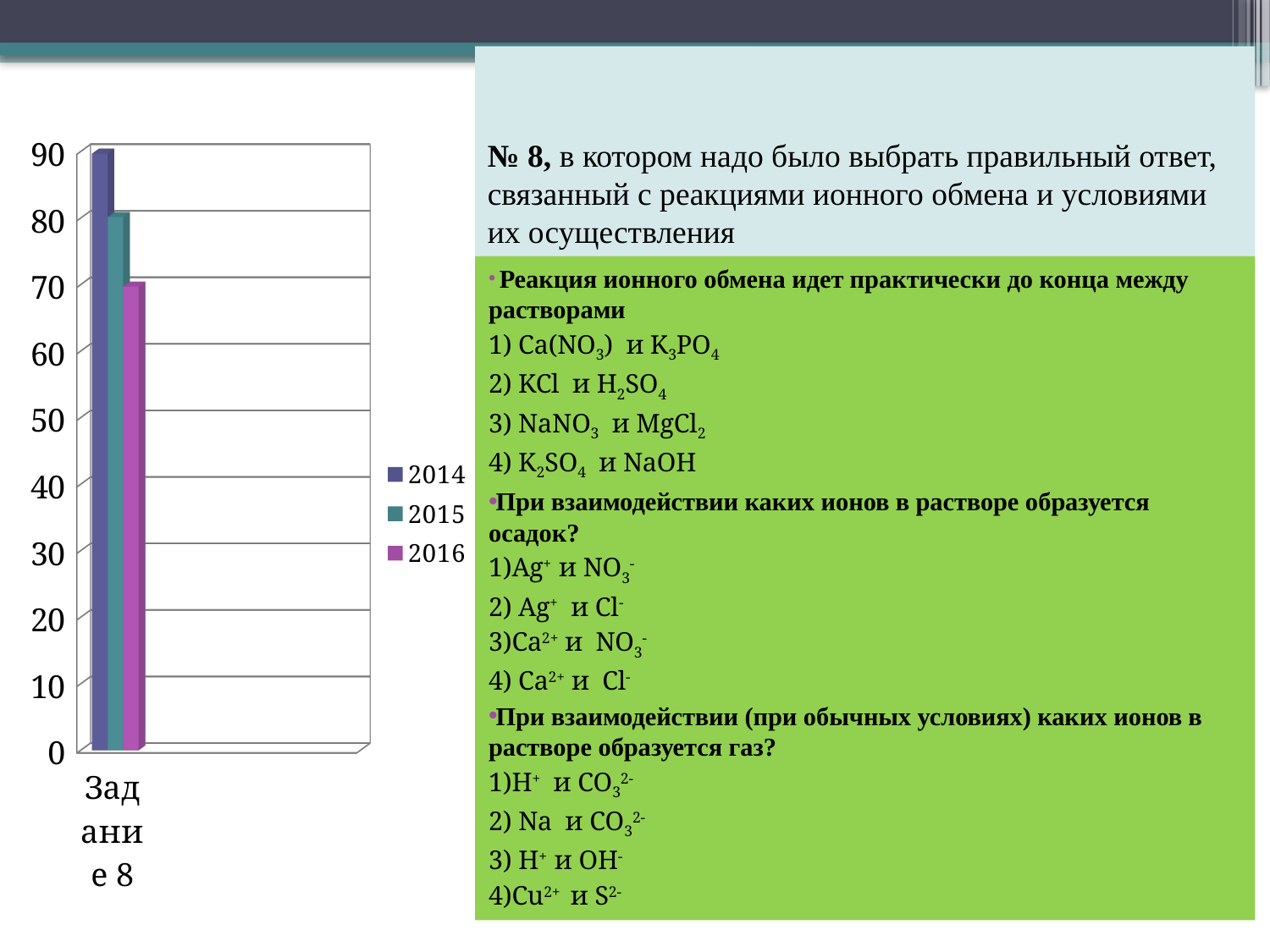
Is the value for 2014 greater or less than 80? greater How many series does the chart legend list? 3 Is the value for 2016 greater or less than 80? less Which series has the highest value for Задание 8? 2014 Do the values fall or rise from 2014 to 2016 for Задание 8? fall Which is larger for Задание 8, the value for 2015 or the value for 2016? 2015 Which years are listed in the chart legend? 2014, 2015, 2016 What is the category label on the x axis of the chart? Задание 8 Is the value for 2015 greater or less than 70? greater How many categories are shown on the x axis of the chart? 1 Which series has the lowest value for Задание 8? 2016 What kind of chart is shown on the slide? bar chart